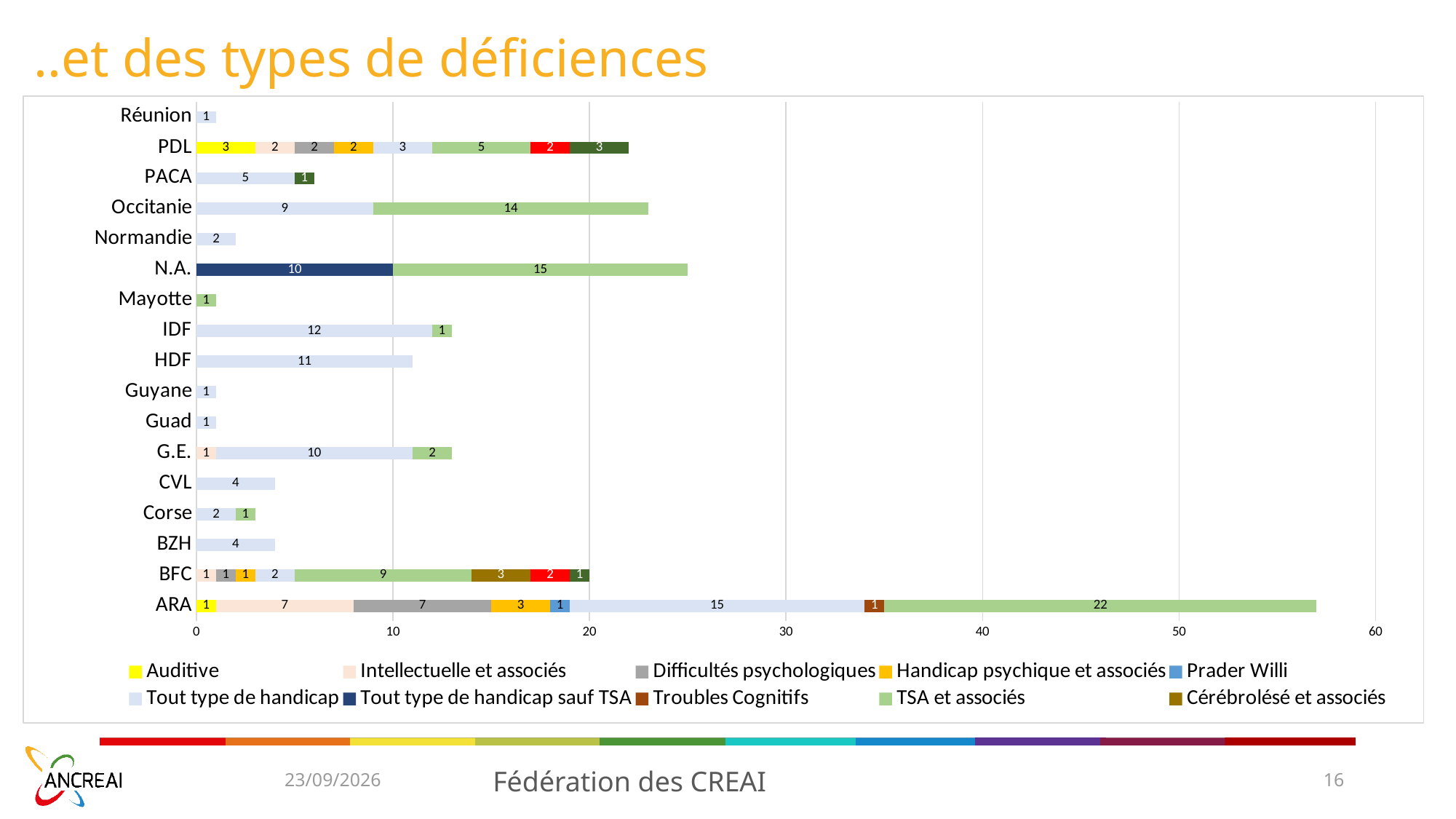
What is the value of 'Tout type de handicap sauf TSA' for N.A.? 10 How many series does the chart legend list? 10 What kind of chart is shown on the slide? bar chart What is the value of 'Tout type de handicap' for HDF? 11 Which has a larger 'Tout type de handicap' value, IDF or HDF? IDF Is the total bar length for ARA greater or less than 50? greater What is the difference between the 'TSA et associés' value for N.A. and for Occitanie? 1 What is the total of the stacked bar for N.A.? 25 How many regions (categories) are listed on the vertical axis of the chart? 17 What is the value of 'TSA et associés' for Occitanie? 14 What is the total of the stacked bar for ARA? 57 Which region has the longest stacked bar overall? ARA